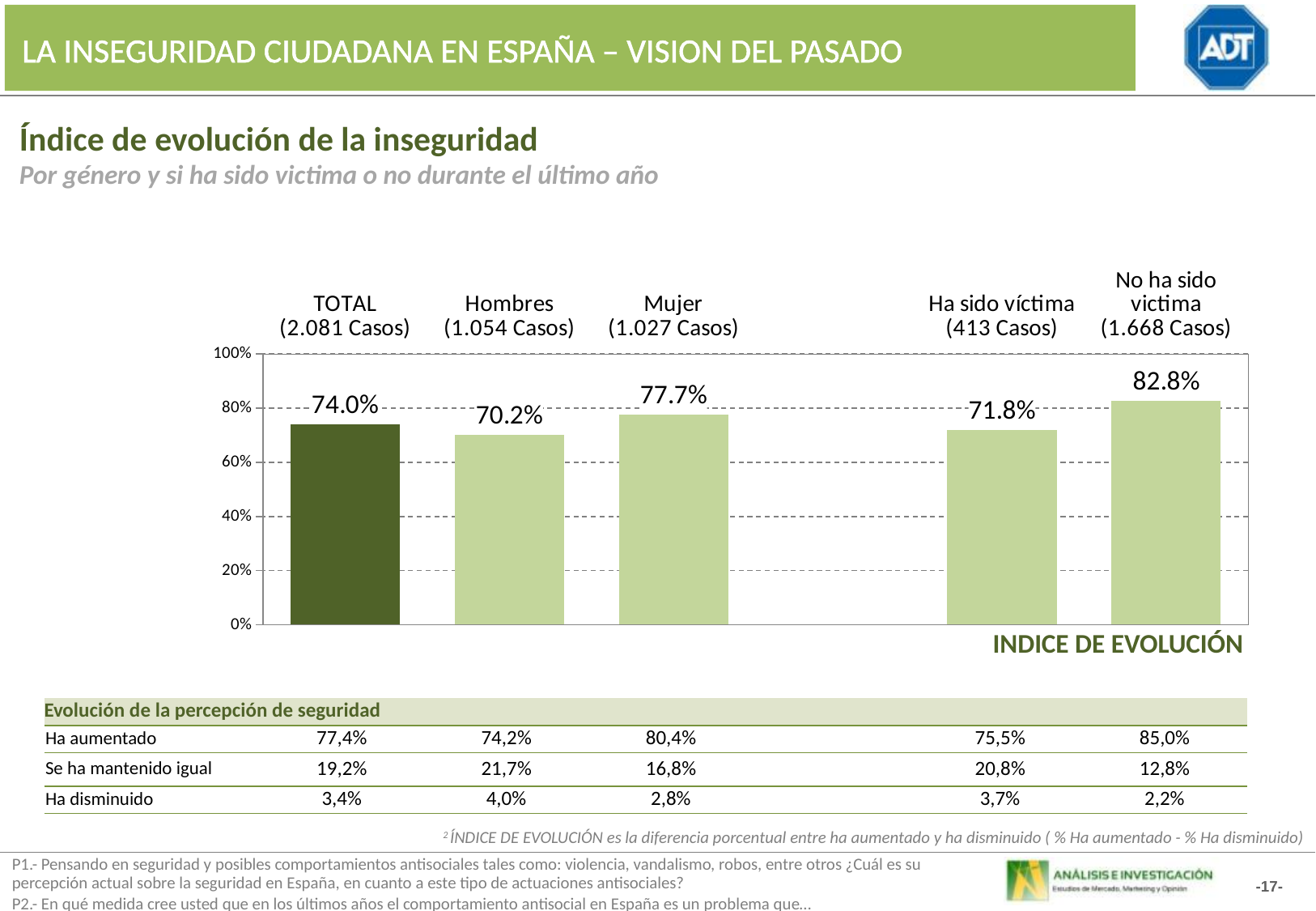
What is the difference between the values for Mujer and Hombres? 7.5% What kind of chart is shown on the slide? bar chart Which category has the lowest bar? Hombres Which is larger, the value for Ha sido víctima or the value for No ha sido víctima? No ha sido víctima What is the value of the bar for Hombres? 70.2% Is the value for Ha sido víctima greater or less than 80%? less What is the value of the bar for Mujer? 77.7% How many cases are indicated for the Ha sido víctima category? 413 Casos What is the value of the bar for TOTAL? 74.0% Which category has the highest bar? No ha sido víctima What is the value of the bar for No ha sido víctima? 82.8% How many bars are plotted in the chart? 5